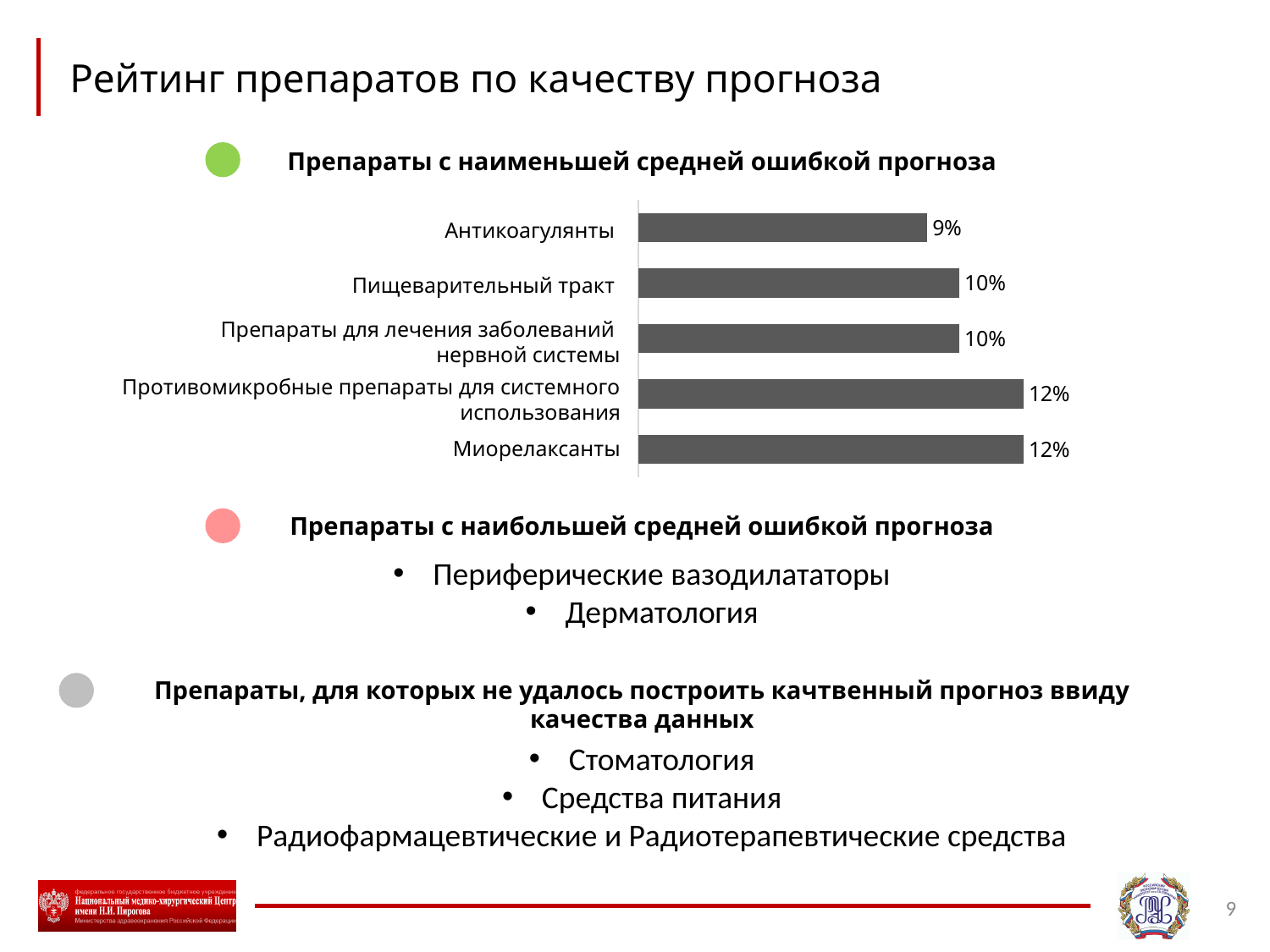
What is the value for Противомикробные препараты для системного использования? 12% Which is larger, the value for Миорелаксанты or the value for Антикоагулянты? Миорелаксанты What is the value for Пищеварительный тракт? 10% What is the title of the chart? Препараты с наименьшей средней ошибкой прогноза What is the value for Миорелаксанты? 12% What kind of chart is shown on the slide? Bar chart How many categories are shown in the chart? 5 What is the difference between the values for Миорелаксанты and Антикоагулянты? 3% Which category has the lowest value in the chart? Антикоагулянты Do the values rise or fall going from the top category to the bottom category? Rise What is the value for Антикоагулянты? 9% What is the value for Препараты для лечения заболеваний нервной системы? 10%